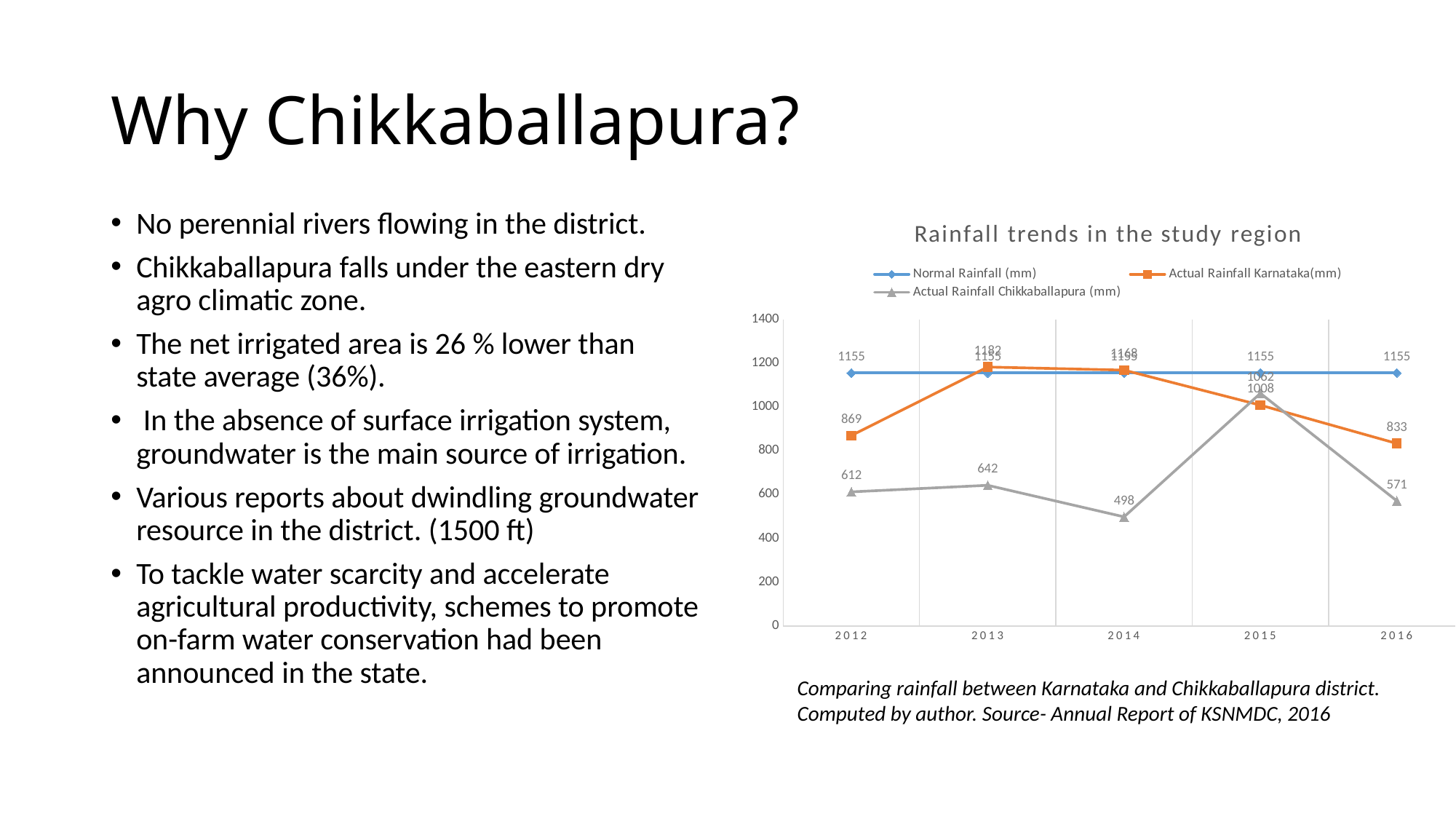
What is the title of the chart? Rainfall trends in the study region In which year is Actual Rainfall Chikkaballapura (mm) highest? 2015 What kind of chart is shown on the slide? line chart How many series does the legend of the rainfall chart list? 3 How many years are plotted on the x axis of the rainfall chart? 5 What is the Actual Rainfall Chikkaballapura (mm) value for 2012? 612 In 2016, which is larger: Actual Rainfall Karnataka(mm) or Actual Rainfall Chikkaballapura (mm)? Actual Rainfall Karnataka(mm) What is the Normal Rainfall (mm) value for 2016? 1155 What is the Actual Rainfall Karnataka(mm) value for 2012? 869 By how much did Actual Rainfall Chikkaballapura (mm) increase from 2012 to 2013? 30 In which year is Actual Rainfall Chikkaballapura (mm) lowest? 2014 What is the Actual Rainfall Chikkaballapura (mm) value for 2014? 498